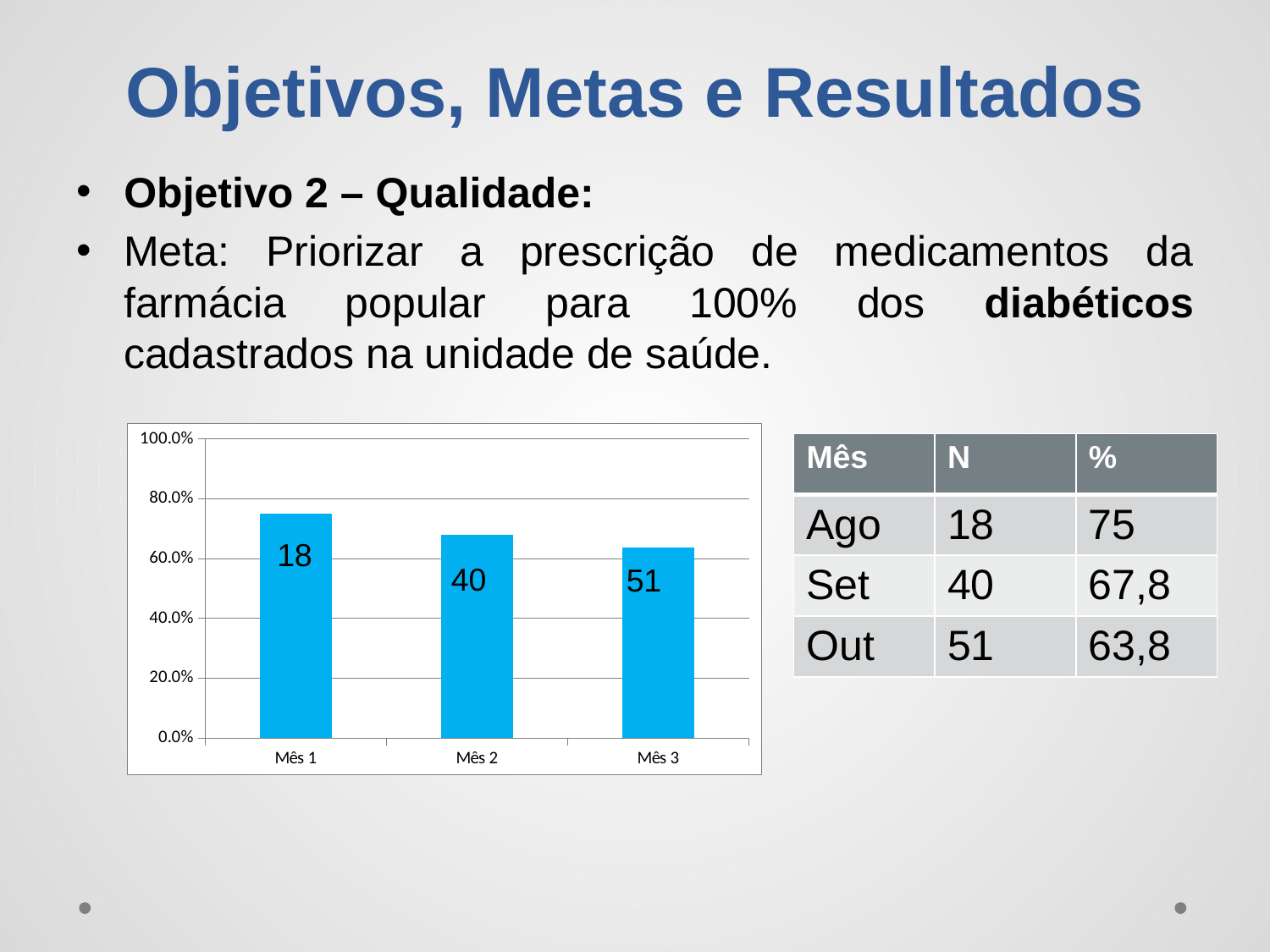
What data label is printed on the bar for Mês 1? 18 Do the bar heights rise or fall from Mês 1 to Mês 3? fall What is the difference between the data labels printed on the bars for Mês 3 and Mês 1? 33 What is the highest tick value shown on the y axis of the chart? 100.0% How many categories are plotted on the x axis of the chart? 3 Is the bar for Mês 1 greater or less than 60.0% on the y axis? greater Is the bar for Mês 2 greater or less than 80.0% on the y axis? less Which category has the tallest bar in the chart? Mês 1 What data label is printed on the bar for Mês 2? 40 Which category has the shortest bar in the chart? Mês 3 What data label is printed on the bar for Mês 3? 51 What kind of chart is shown on the slide? bar chart